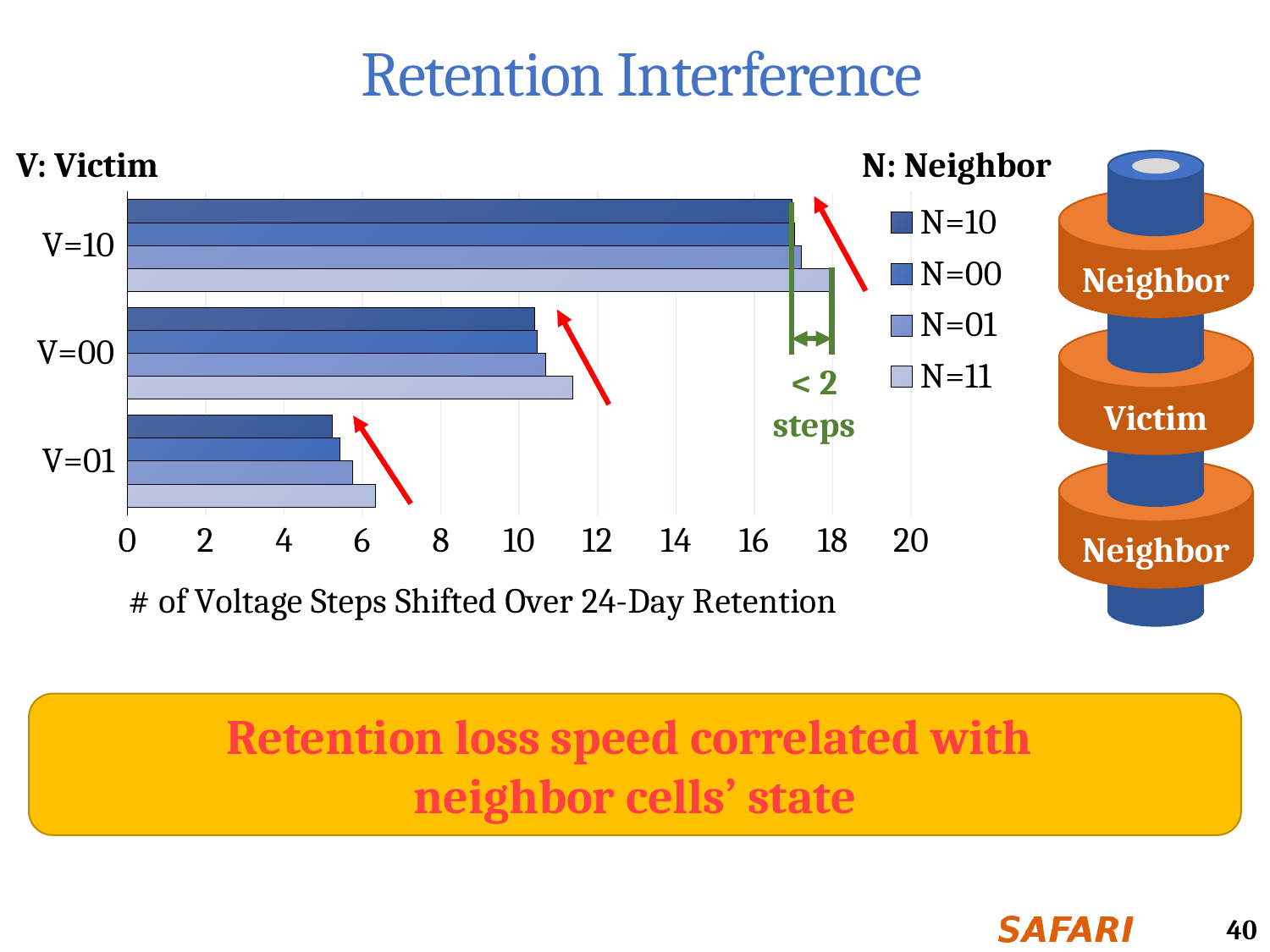
What is the label of the chart's x axis? # of Voltage Steps Shifted Over 24-Day Retention Which victim category has the largest number of voltage steps shifted? V=10 How many victim categories (V values) are shown on the y axis of the chart? 3 Is the value for V=10 with N=11 greater or less than 16? greater Is the value for V=00 with N=11 greater or less than 10? greater Is the value for V=01 with N=11 greater or less than 8? less What is the title of the slide containing the chart? Retention Interference How many series does the chart's legend list? 4 What kind of chart is shown on the slide? bar chart Which victim category has the smallest number of voltage steps shifted? V=01 Within the V=01 category, which neighbor state has the larger value: N=10 or N=11? N=11